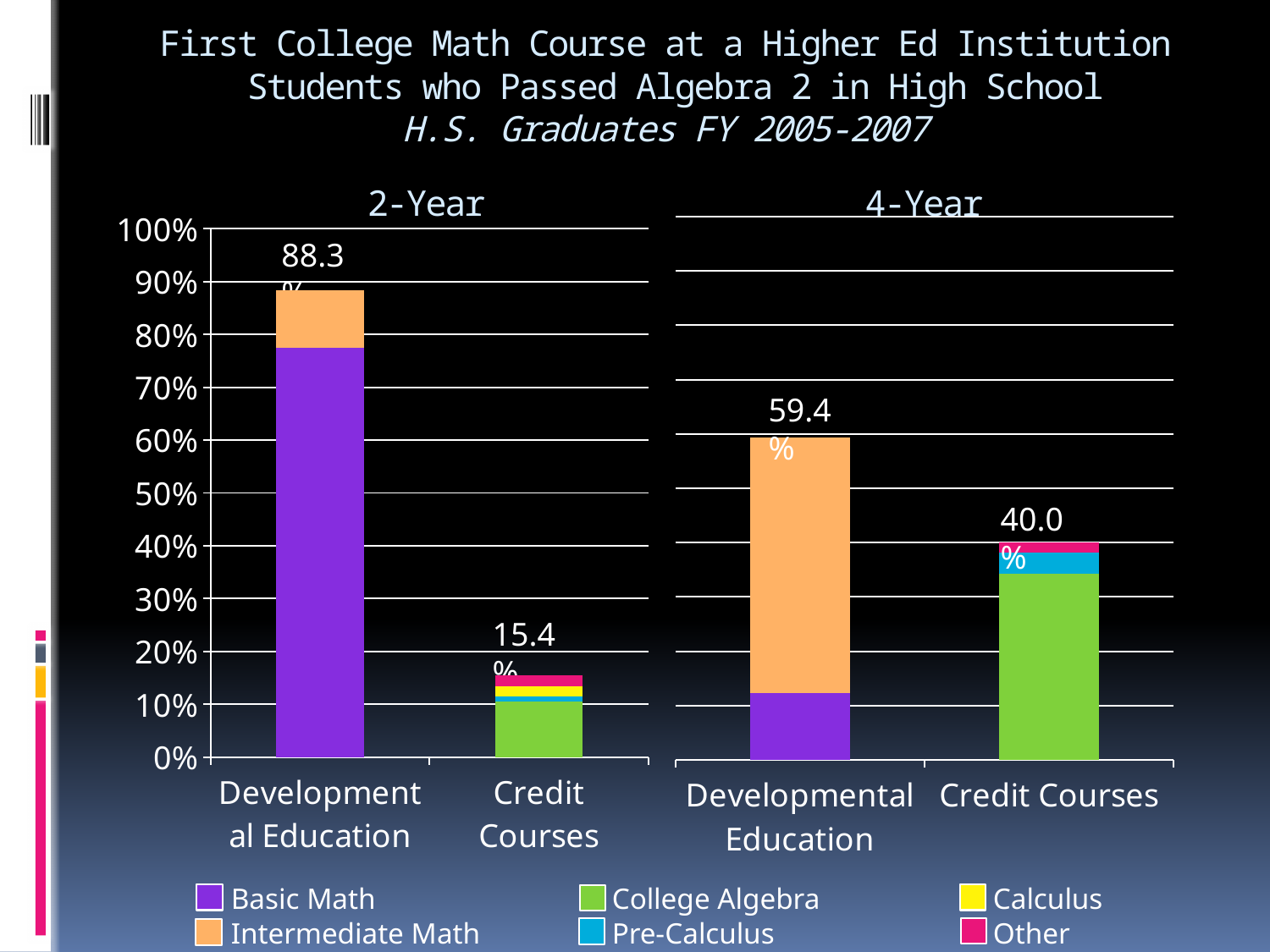
In the 2-Year chart, what total is labeled on the Developmental Education bar? 88.3% In the 4-Year chart, what is the difference between the Developmental Education total and the Credit Courses total? 19.4% In the 4-Year chart, what total is labeled on the Developmental Education bar? 59.4% In the 2-Year chart, is the Basic Math portion of the Developmental Education bar greater or less than 70%? greater Which chart has the larger Developmental Education total, 2-Year or 4-Year? 2-Year What kind of chart is the 4-Year chart? stacked bar chart In the 2-Year chart, what total is labeled on the Credit Courses bar? 15.4% In the 2-Year chart, what is the difference between the Developmental Education total and the Credit Courses total? 72.9% How many series does the legend list? 6 Which series is shown in orange in the legend? Intermediate Math In the 4-Year chart, is the Basic Math portion of the Developmental Education bar greater or less than 20%? less